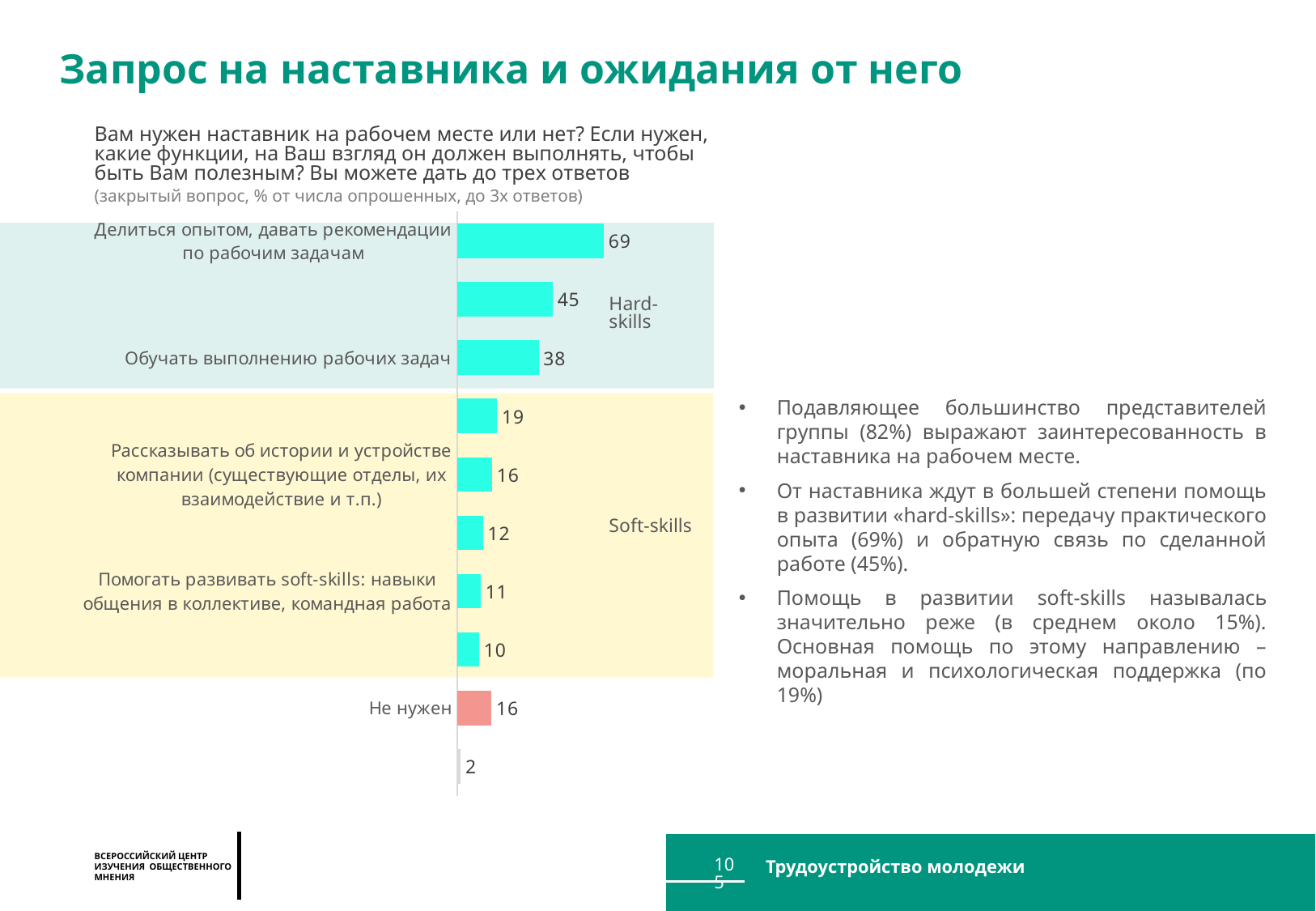
What kind of chart is shown on the slide? bar chart What colour is the bar for "Не нужен"? red (pink) What is the value for "Делиться опытом, давать рекомендации по рабочим задачам"? 69 What is the smallest value shown in the chart? 2 What is the value for "Не нужен"? 16 Which is larger: the value for "Обучать выполнению рабочих задач" or the value for "Не нужен"? Обучать выполнению рабочих задач How many bars are plotted in the chart? 10 Which category has the highest value in the chart? Делиться опытом, давать рекомендации по рабочим задачам What is the value for "Обучать выполнению рабочих задач"? 38 What is the difference between the values for "Делиться опытом, давать рекомендации по рабочим задачам" and "Обучать выполнению рабочих задач"? 31 How many bars are in the "Hard-skills" group of the chart? 3 How many bars are in the "Soft-skills" group of the chart? 5